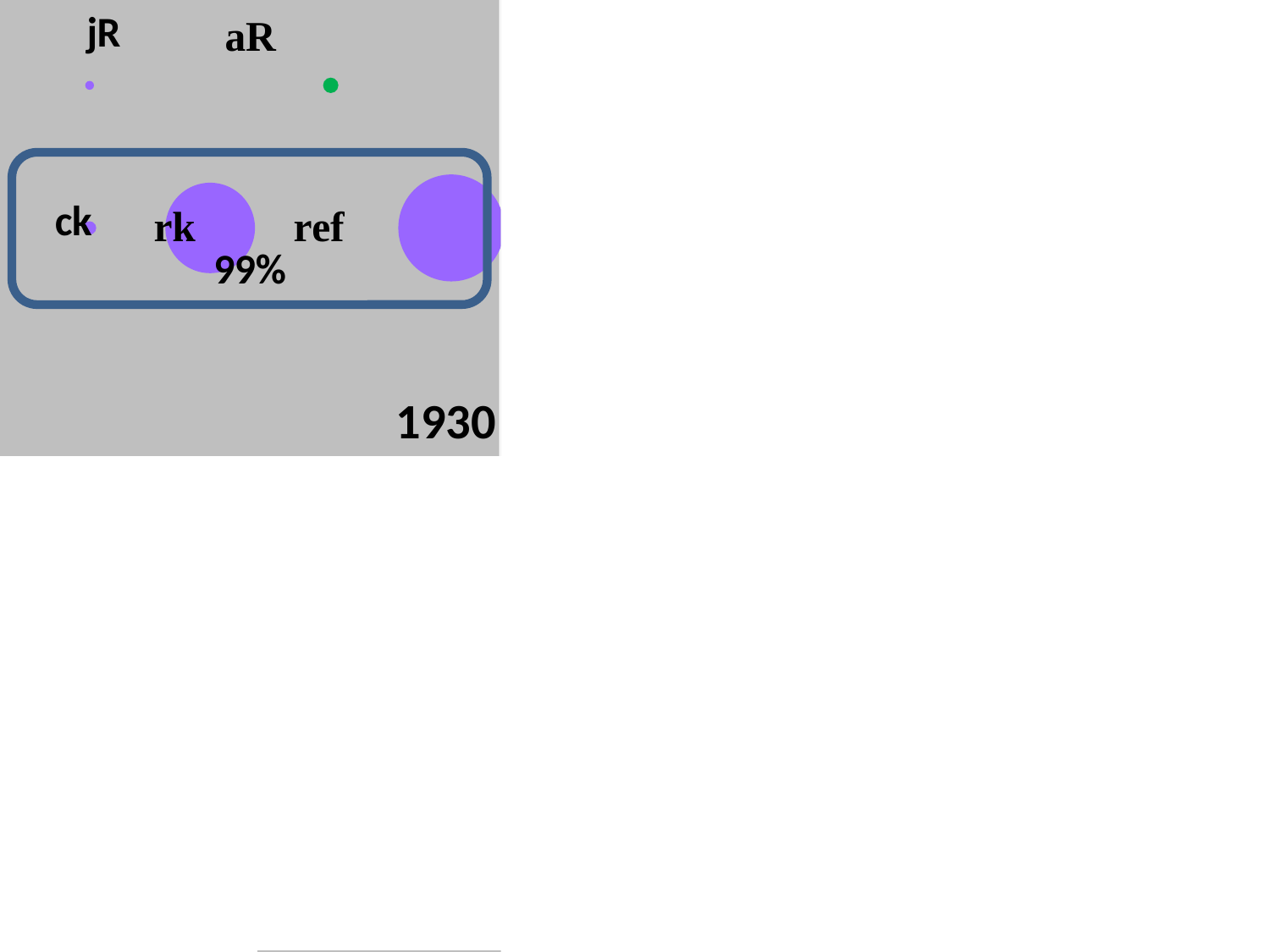
Which bubble is the largest on the chart? ref Which bubble is larger, rk or ck? rk How many labelled bubbles are plotted on the chart? 5 What percentage label is printed inside the outlined box on the chart? 99% Which bubble on the chart is coloured green? aR Which bubble is larger, ref or jR? ref What year is printed in the bottom-right corner of the chart? 1930 What kind of chart is shown on the slide? bubble chart Which bubble is larger, rk or aR? rk